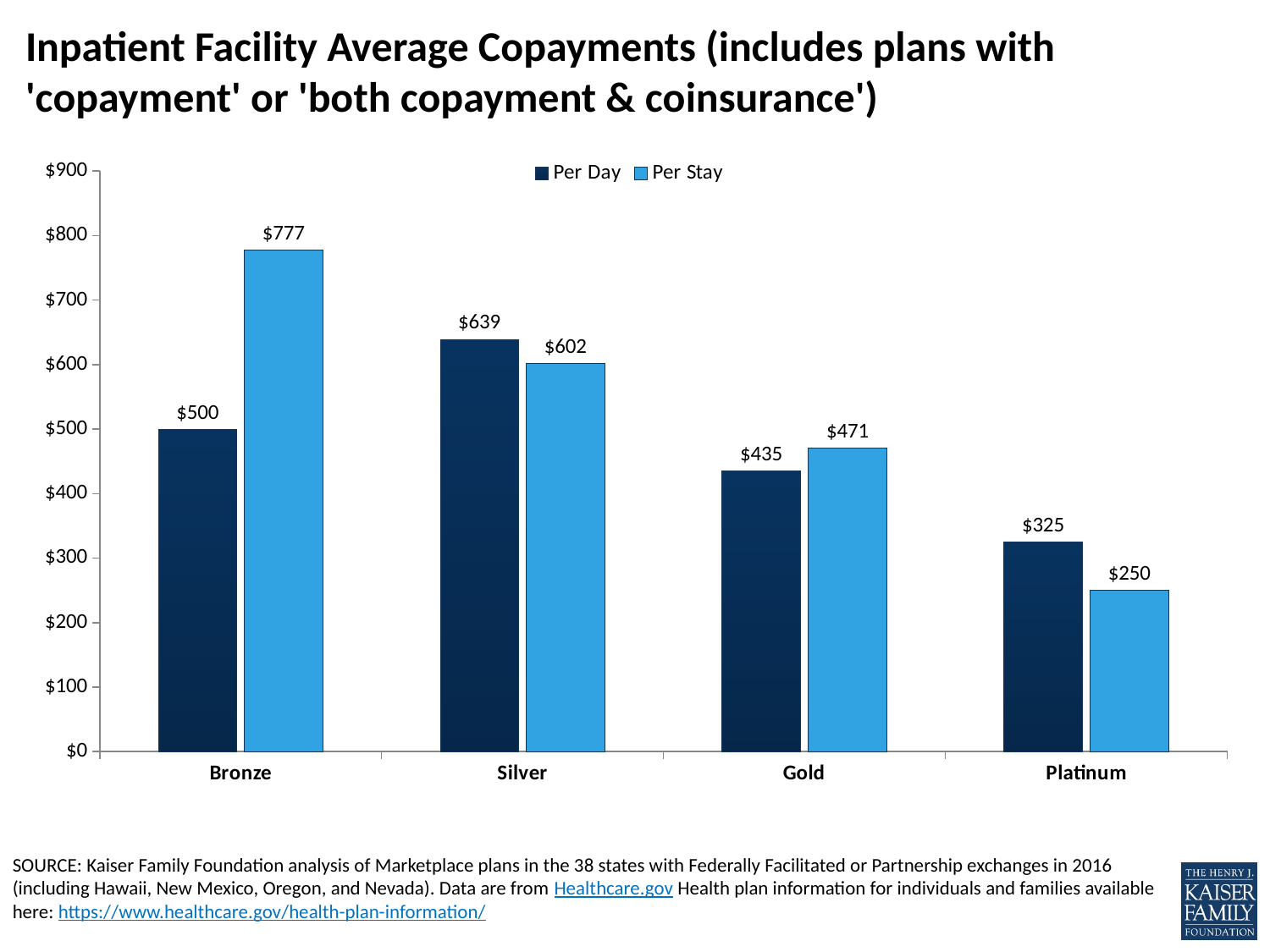
What kind of chart is shown on the slide? Bar chart What is the difference between the Per Stay and Per Day copayments for Bronze plans? $277 For Gold plans, which is larger: the Per Day or the Per Stay copayment? Per Stay Is the Per Day copayment for Platinum plans greater or less than $400? less Which plan tier has the lowest Per Day average copayment? Platinum Which plan tier has the highest Per Stay average copayment? Bronze What is the Per Stay average copayment for Bronze plans? $777 What is the Per Stay average copayment for Platinum plans? $250 What is the difference between the Per Day copayments for Silver and Gold plans? $204 How many plan tiers are shown on the x axis? 4 How many series does the legend list? 2 What is the Per Day average copayment for Silver plans? $639